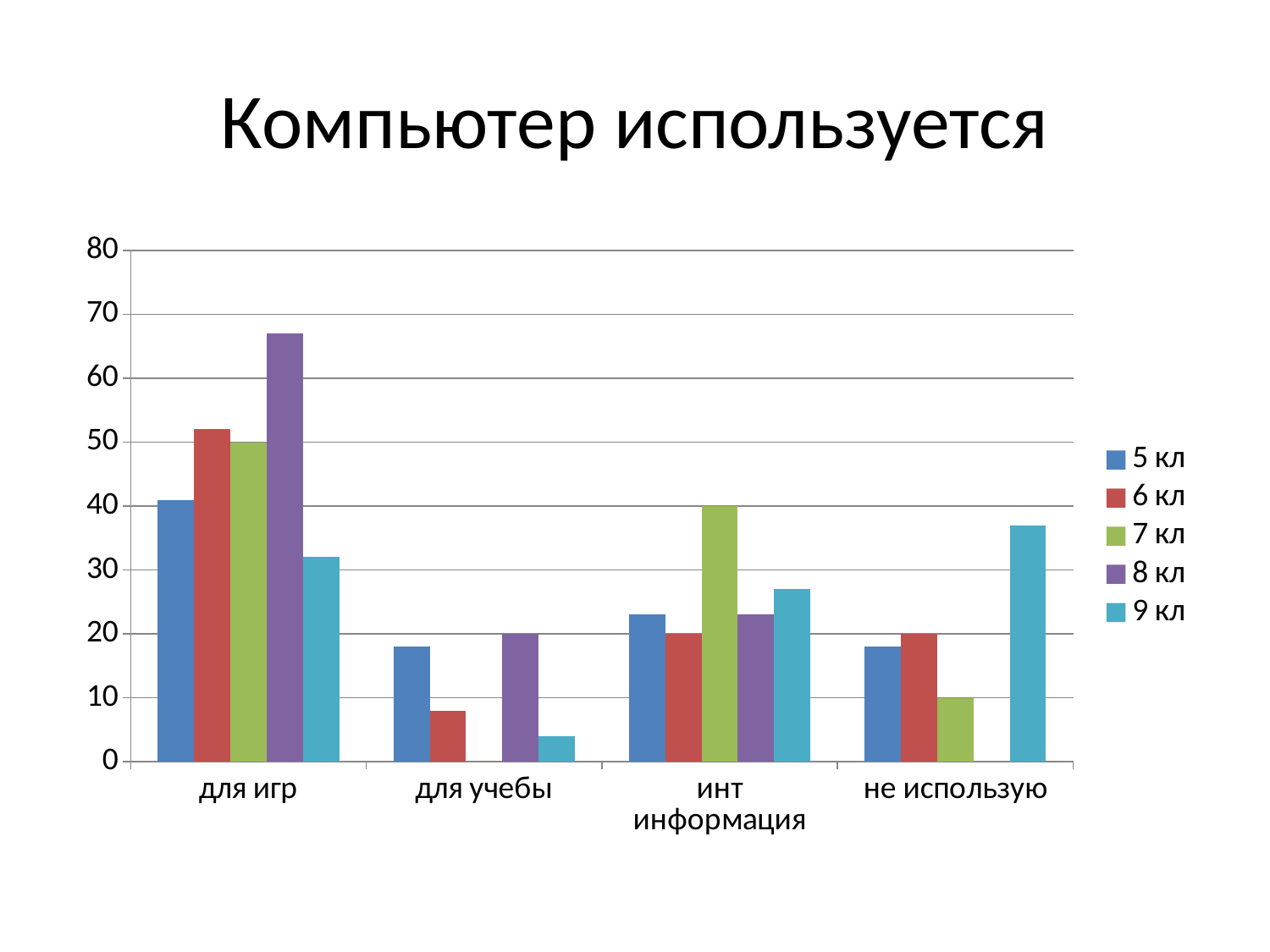
How many categories are shown on the x axis? 4 Which is larger for 'не использую': the value for 5 кл or the value for 9 кл? 9 кл How many series does the legend list? 5 Which series has the highest value for 'инт информация'? 7 кл Is the value for 9 кл in 'для учебы' greater or less than 10? less Is the value for 8 кл in 'для игр' greater or less than 60? greater Which series has the highest value for 'для игр'? 8 кл What kind of chart is shown on the slide? bar chart Which is larger for 'для игр': the value for 5 кл or the value for 6 кл? 6 кл What is the title of the chart? Компьютер используется Is the value for 9 кл in 'не использую' greater or less than 30? greater